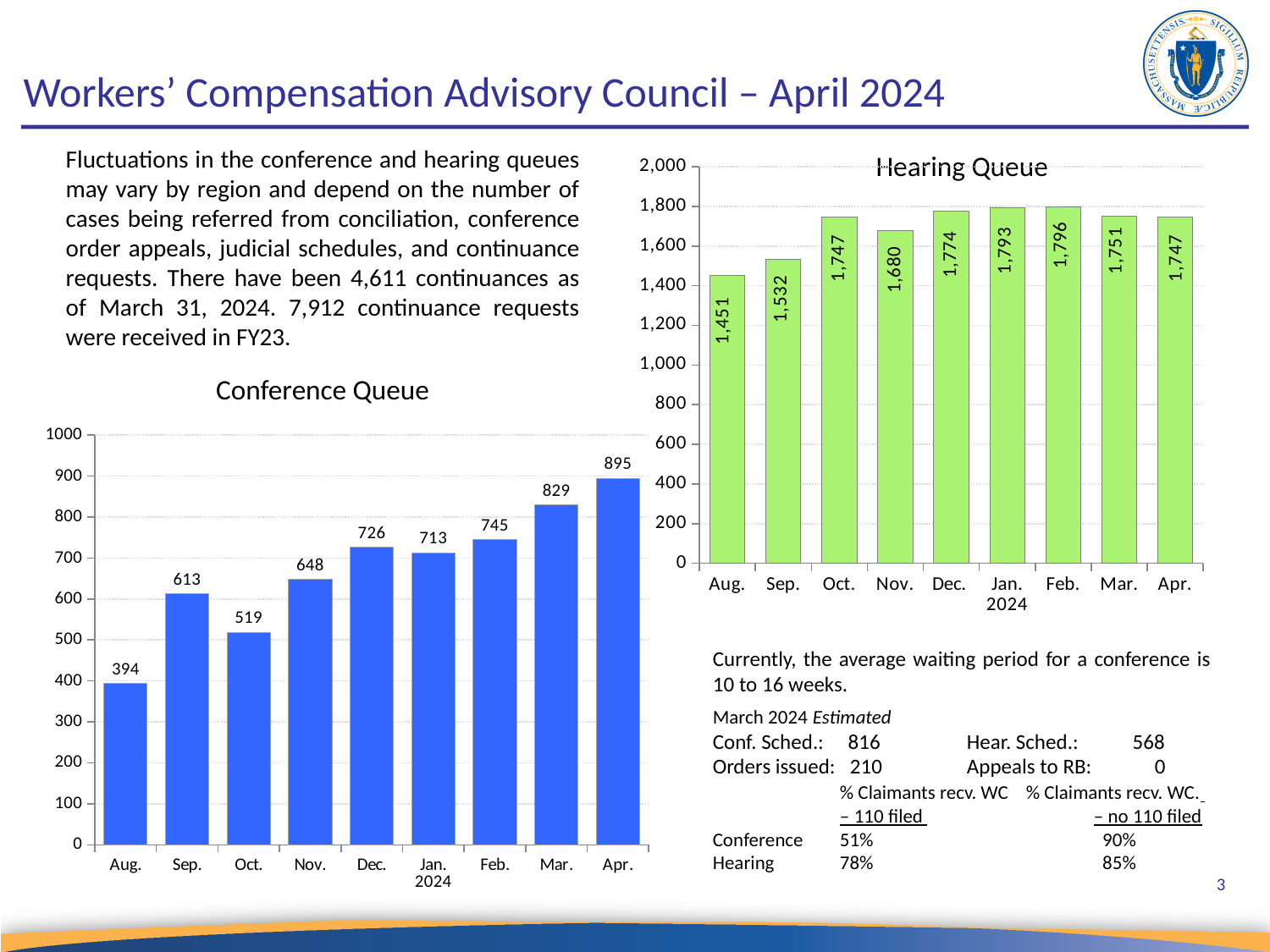
In the Hearing Queue chart, which month has the highest value? Feb. What colour are the bars in the Conference Queue chart? Blue In the Conference Queue chart, what is the difference between the values for Mar. and Feb.? 84 In the Hearing Queue chart, what is the value for Nov.? 1,680 In the Conference Queue chart, which month has the lowest value? Aug. In the Hearing Queue chart, which is larger, the value for Dec. or the value for Mar.? Dec. In the Conference Queue chart, which is larger, the value for Dec. or the value for Jan. 2024? Dec. In the Conference Queue chart, what is the value for Apr.? 895 What kind of chart is the Hearing Queue chart? Bar chart In the Conference Queue chart, is the value for Oct. greater or less than 500? greater In the Conference Queue chart, how many months are plotted? 9 In the Hearing Queue chart, what is the difference between the values for Sep. and Aug.? 81